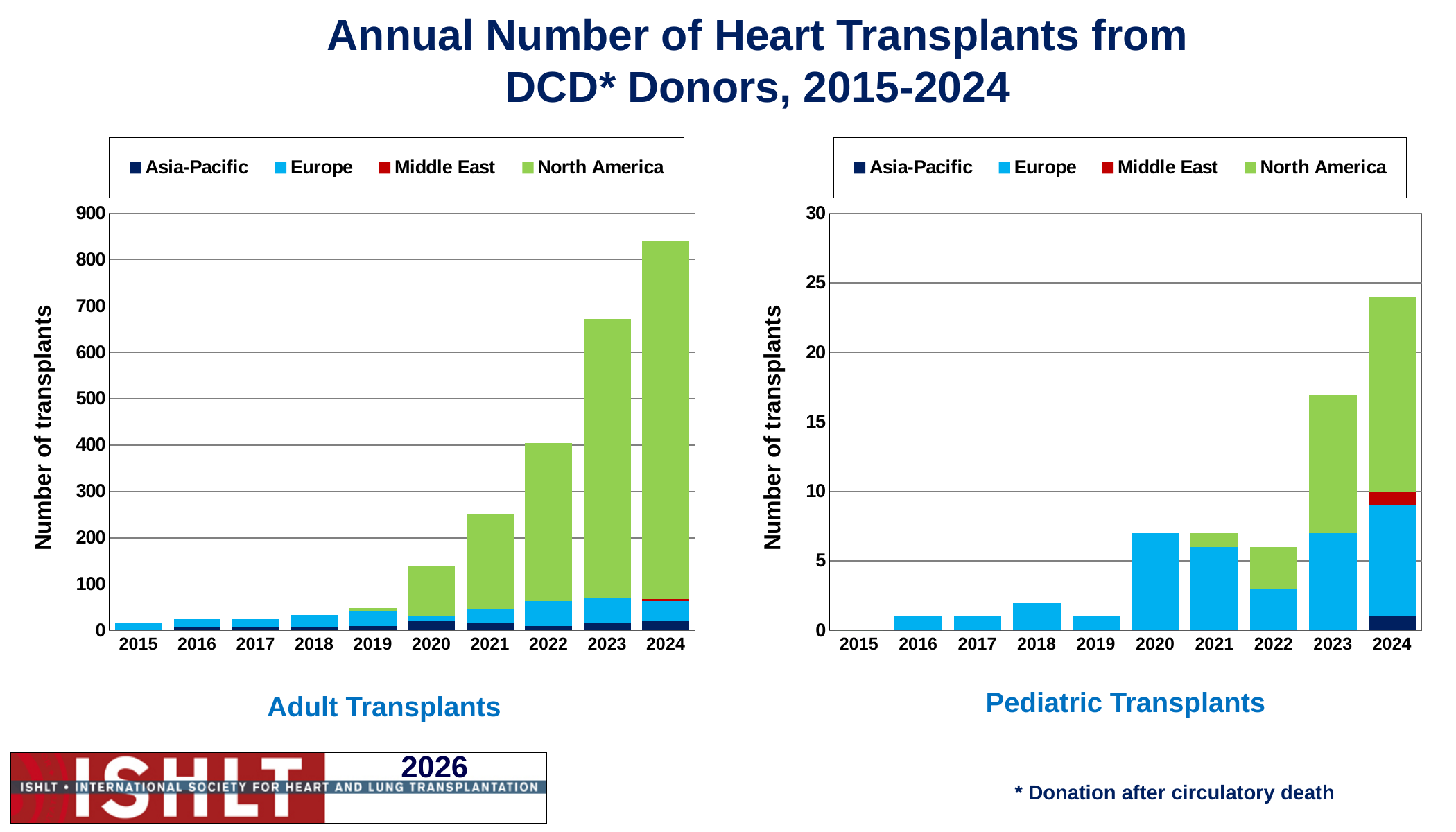
How many years are shown on the x axis of the Adult Transplants chart? 10 In the Adult Transplants chart, is the total for 2023 greater or less than 600? greater In the Pediatric Transplants chart, is the total for 2024 greater or less than 20? greater In the Adult Transplants chart, which year has the lowest total number of transplants? 2015 In the Adult Transplants chart, do the totals generally rise or fall from 2015 to 2024? rise In the Adult Transplants chart, which year has the highest total number of transplants? 2024 What kind of chart is the Adult Transplants chart? bar chart In the Pediatric Transplants chart, is the total for 2018 greater or less than 5? less In the Pediatric Transplants chart, which year has the highest total number of transplants? 2024 How many series does the legend of the Pediatric Transplants chart list? 4